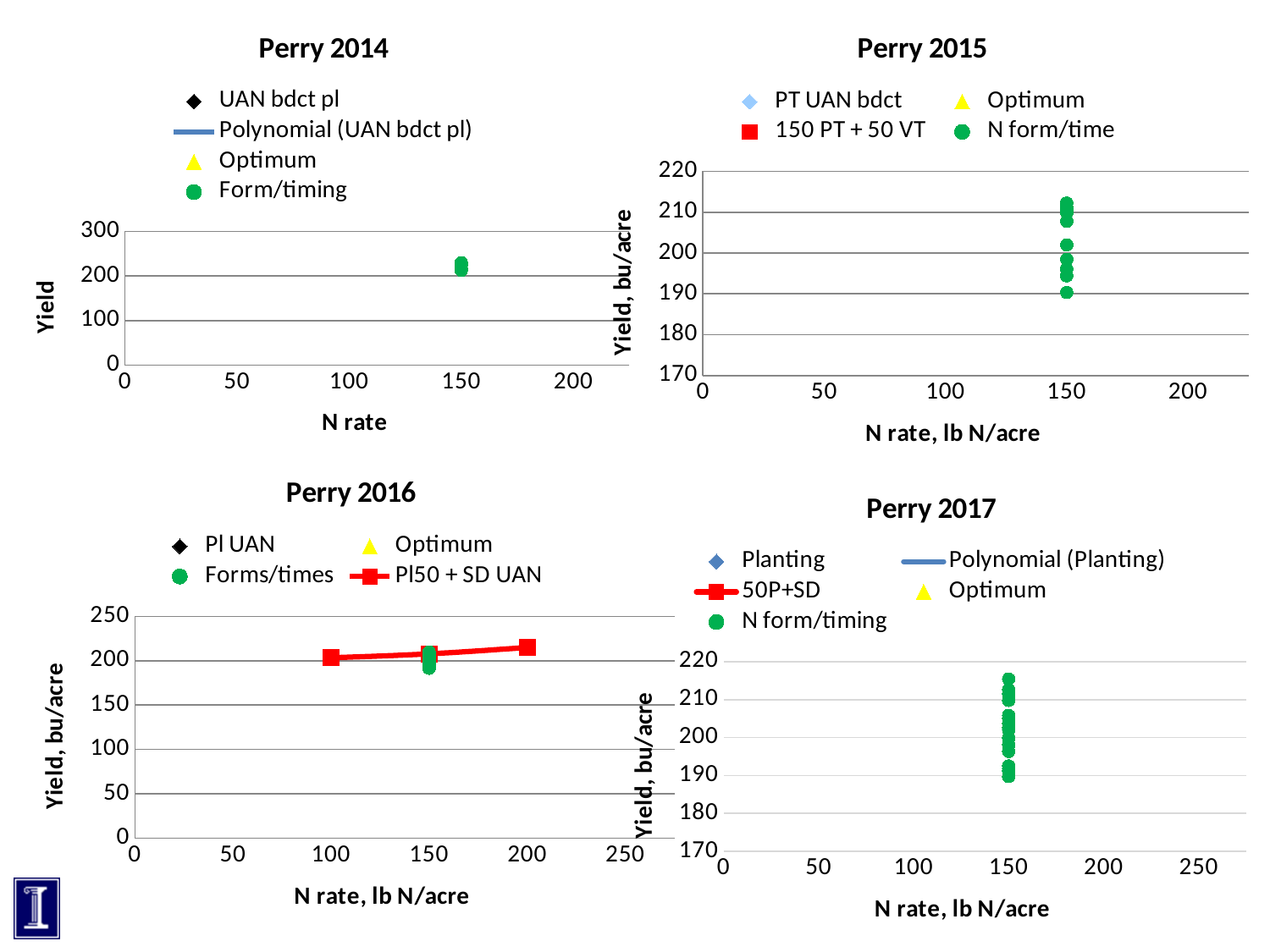
How many series does the legend of the Perry 2014 chart list? 4 How many series does the legend of the Perry 2015 chart list? 4 In the Perry 2016 chart, is the Pl50 + SD UAN value at N rate 200 greater or less than 200? greater In the Perry 2015 chart, at what N rate are all the N form/time points plotted? 150 What kind of chart is the Perry 2014 chart? scatter chart In the Perry 2015 chart, are the N form/time yield values at N rate 150 greater or less than 180? greater In the Perry 2014 chart, are the Form/timing yield values at N rate 150 greater or less than 200? greater In the Perry 2016 chart, does the Pl50 + SD UAN line rise or fall as N rate increases? rise In the Perry 2016 chart, how many points does the Pl50 + SD UAN series have? 3 How many series does the legend of the Perry 2017 chart list? 5 What is the x-axis title of the Perry 2014 chart? N rate